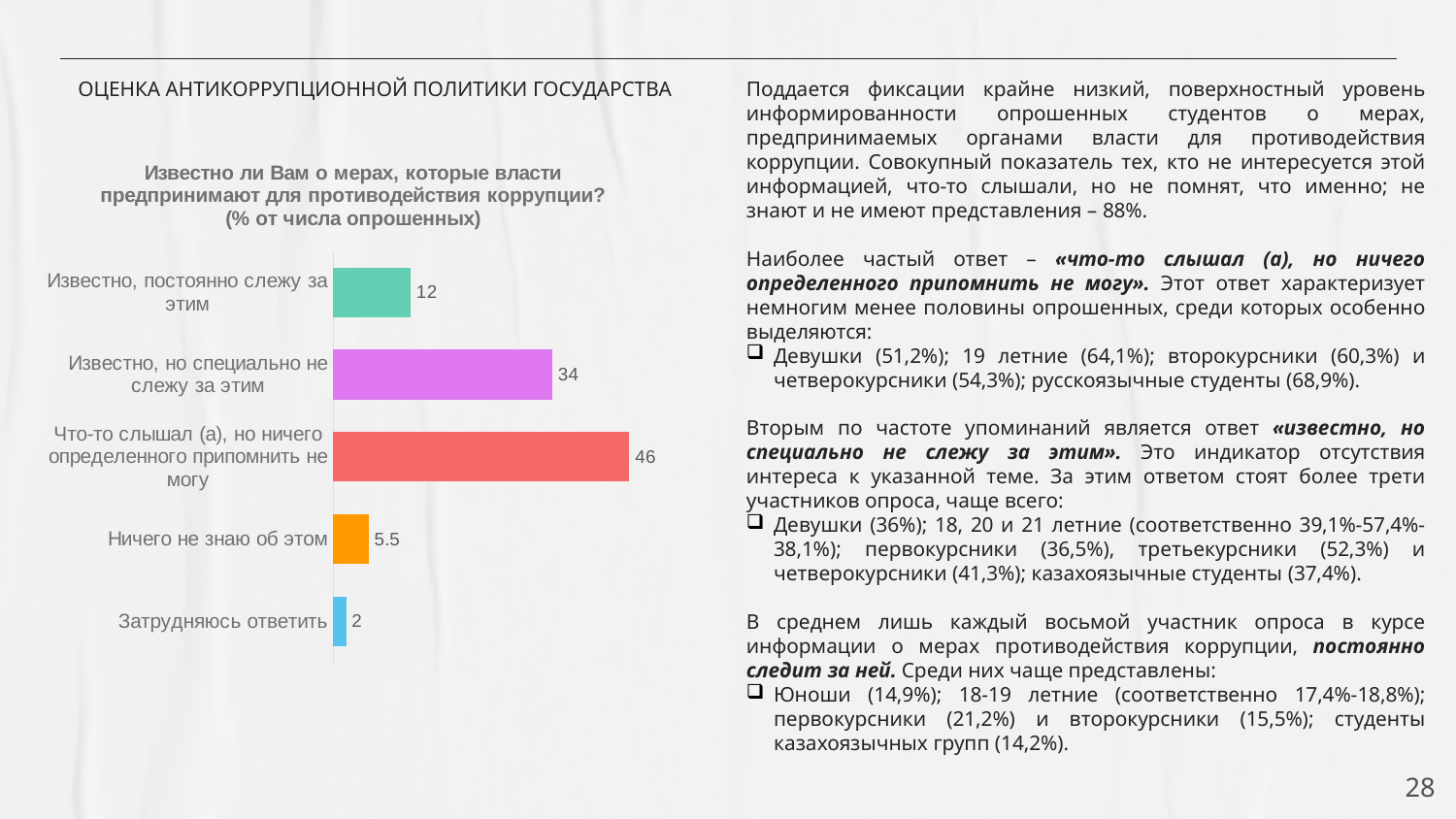
What value is shown for the category "Ничего не знаю об этом"? 5.5 What is the title of the chart? Известно ли Вам о мерах, которые власти предпринимают для противодействия коррупции? (% от числа опрошенных) What is the difference between the values for "Что-то слышал (а), но ничего определенного припомнить не могу" and "Известно, но специально не слежу за этим"? 12 Which is larger: the value for "Известно, постоянно слежу за этим" or the value for "Ничего не знаю об этом"? Известно, постоянно слежу за этим How many categories are shown in the chart? 5 What value is shown for the category "Известно, но специально не слежу за этим"? 34 What value is shown for the category "Что-то слышал (а), но ничего определенного припомнить не могу"? 46 Which category has the lowest value in the chart? Затрудняюсь ответить What type of chart is shown on the slide? Bar chart Which category has the highest value in the chart? Что-то слышал (а), но ничего определенного припомнить не могу What value is shown for the category "Затрудняюсь ответить"? 2 What value is shown for the category "Известно, постоянно слежу за этим"? 12